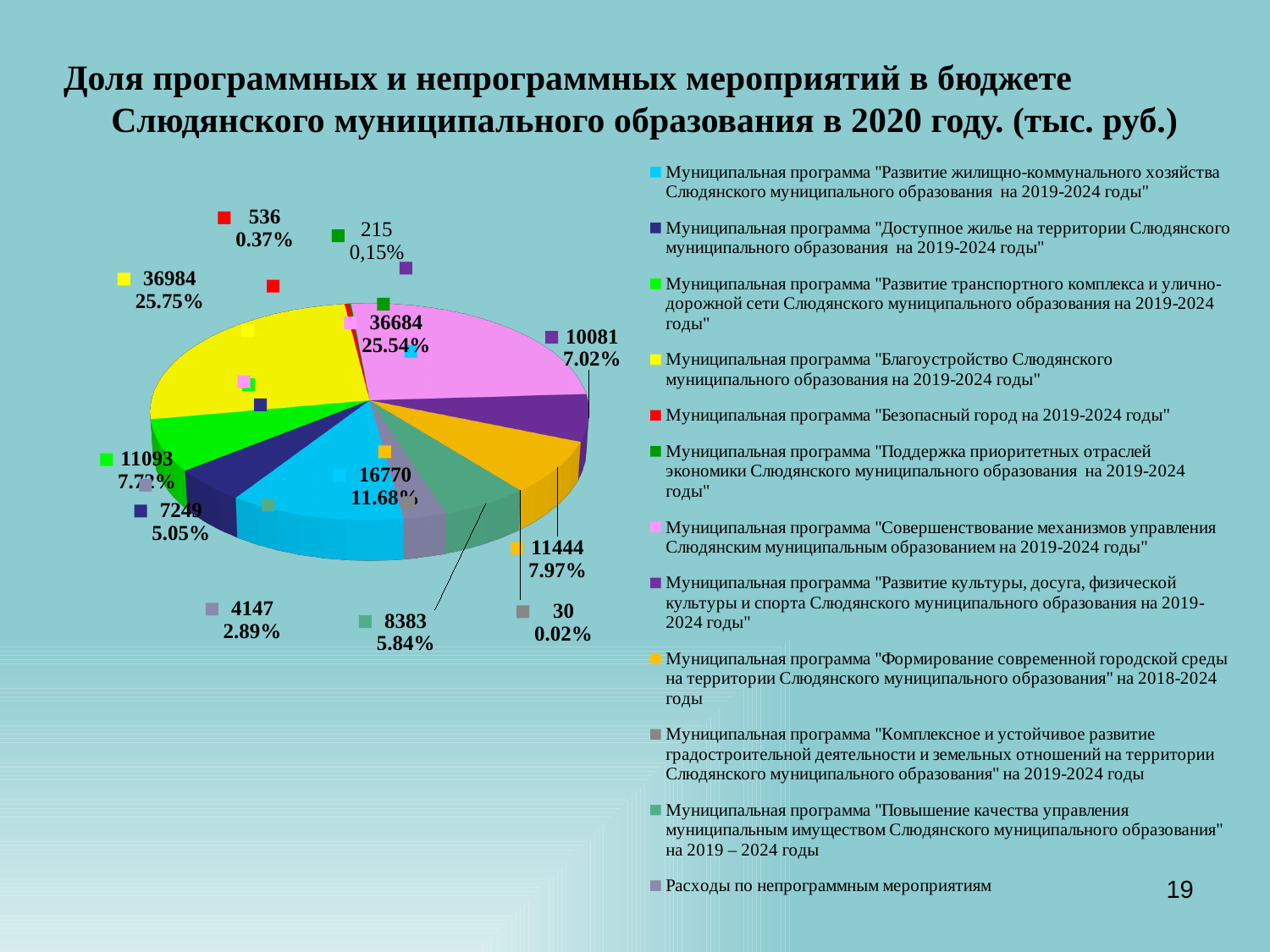
What is the value (тыс. руб.) for "Расходы по непрограммным мероприятиям"? 4147 What is the value (тыс. руб.) for the programme "Развитие жилищно-коммунального хозяйства"? 16770 What kind of chart is shown on the slide? Pie chart What share of the pie does the programme "Совершенствование механизмов управления" have? 25.54% What is the value (тыс. руб.) for the programme "Благоустройство Слюдянского муниципального образования на 2019-2024 годы"? 36984 How many entries does the chart legend list? 12 What share of the pie does the programme "Безопасный город на 2019-2024 годы" have? 0.37% How many slices does the pie chart have? 12 Which programme has the largest slice of the pie? Благоустройство Слюдянского муниципального образования на 2019-2024 годы What is the difference between the values for "Благоустройство" (36984) and "Совершенствование механизмов управления" (36684)? 300 Which category has the smallest slice of the pie? Муниципальная программа "Комплексное и устойчивое развитие градостроительной деятельности и земельных отношений на территории Слюдянского муниципального образования" на 2019-2024 годы Which is larger: the value for "Развитие жилищно-коммунального хозяйства" or the value for "Формирование современной городской среды"? Развитие жилищно-коммунального хозяйства